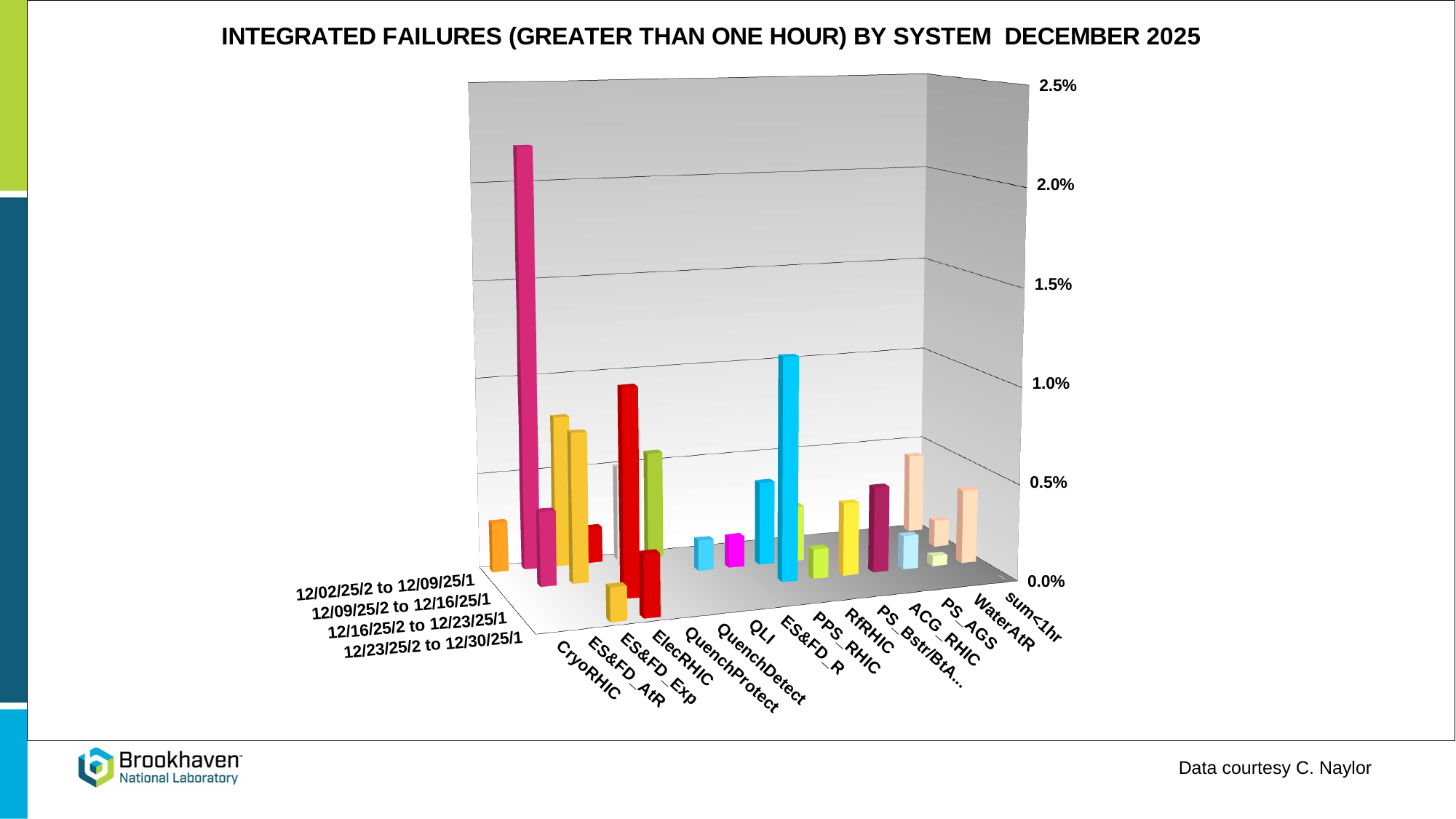
What is the title of the chart? INTEGRATED FAILURES (GREATER THAN ONE HOUR) BY SYSTEM DECEMBER 2025 Is the tallest bar in the chart greater or less than 1.5%? greater Which time period is listed last (at the front) on the depth axis of the chart? 12/23/25/2 to 12/30/25/1 How many weekly time periods (series) are plotted along the depth axis of the chart? 4 Which category is listed first on the x axis of the chart? CryoRHIC Which time period is listed first (at the back) on the depth axis of the chart? 12/02/25/2 to 12/09/25/1 What kind of chart is shown on the slide? bar chart Which category is listed last on the x axis of the chart? sum<1hr What is the highest value shown on the vertical axis of the chart? 2.5% Is the tallest bar in the chart greater or less than 2.5%? less How many system categories are listed along the x axis of the chart? 15